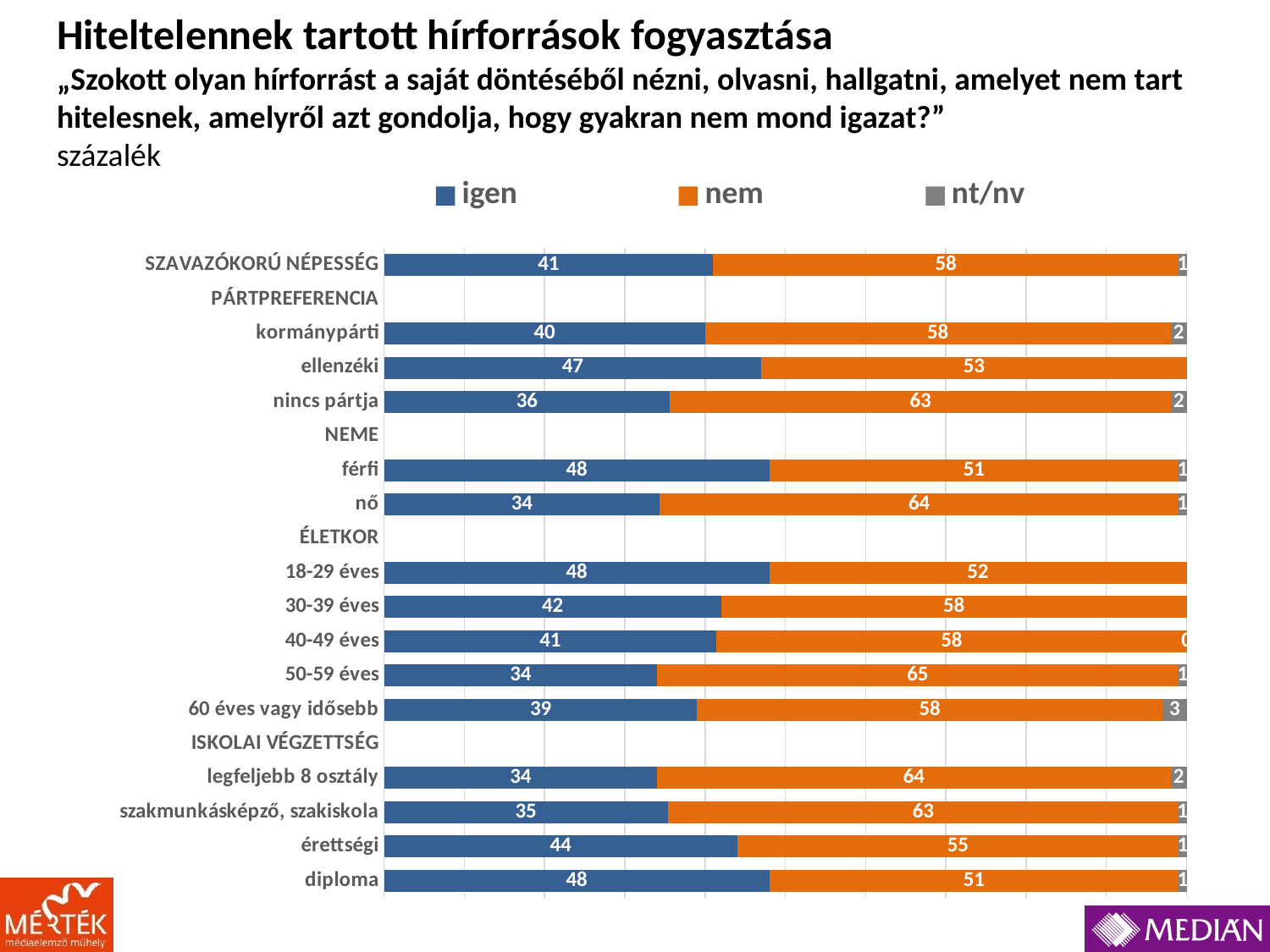
How many categories have bars plotted in the chart? 15 Which series is shown in orange in the legend? nem What is the difference between the "nem" and "igen" values for nő? 30 What is the "igen" value for SZAVAZÓKORÚ NÉPESSÉG? 41 Which category has the highest "nt/nv" value? 60 éves vagy idősebb What is the "nem" value for nincs pártja? 63 Which has a larger "igen" value, ellenzéki or kormánypárti? ellenzéki How many series does the legend list? 3 Which category has the highest "nem" value? 50-59 éves What kind of chart is shown on the slide? stacked bar chart What is the "nt/nv" value for 60 éves vagy idősebb? 3 What is the total of the stacked bar for kormánypárti? 100